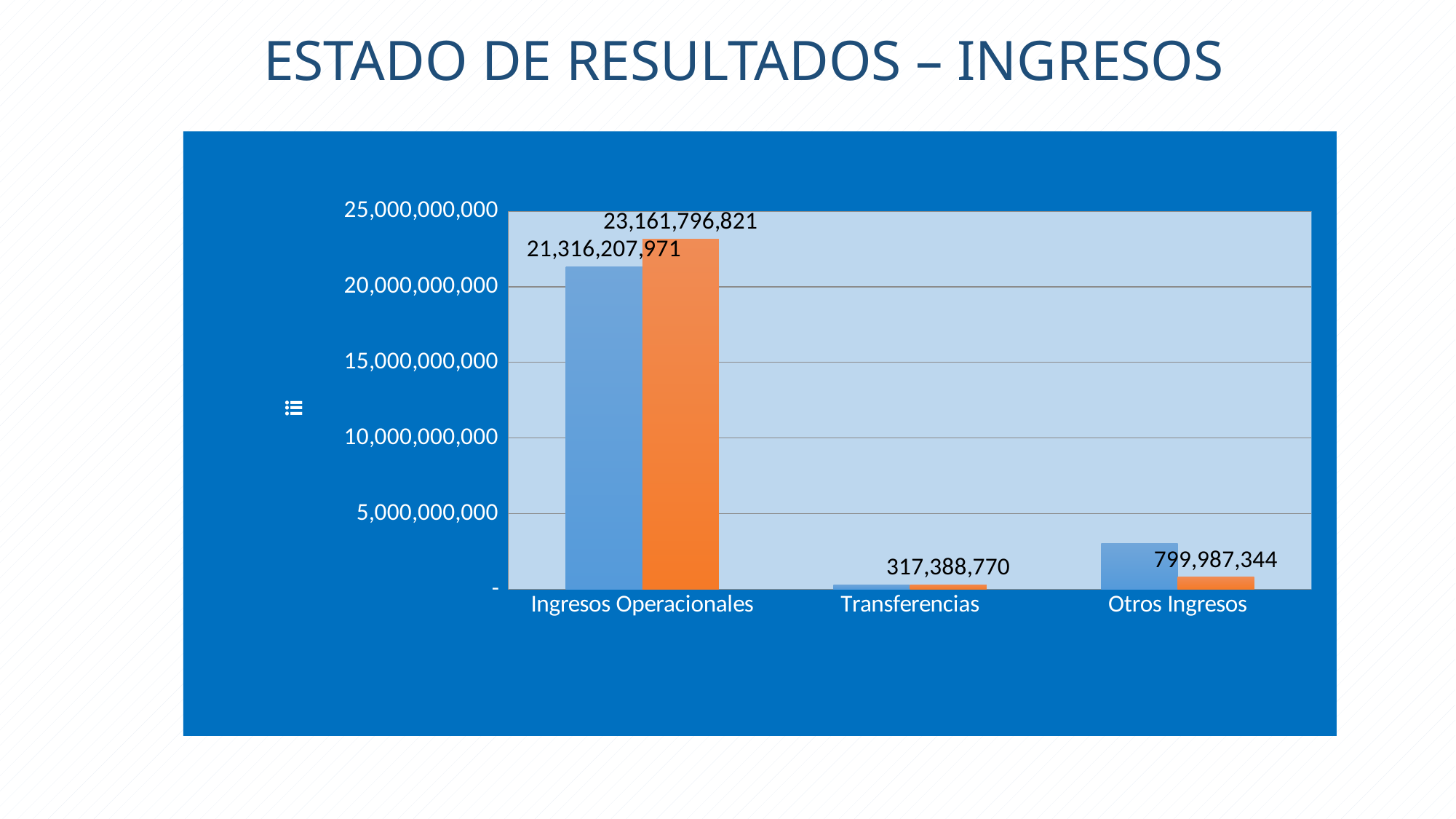
What is the title of the slide containing the chart? ESTADO DE RESULTADOS – INGRESOS What kind of chart is shown on the slide? bar chart Which category has the highest values in the chart? Ingresos Operacionales What is the difference between the orange bar and the blue bar for Ingresos Operacionales? 1,845,588,850 What value is labelled for Otros Ingresos? 799,987,344 For Ingresos Operacionales, which bar is larger, the blue one or the orange one? orange What value is labelled for Transferencias? 317,388,770 Is the value of the blue bar for Otros Ingresos greater or less than 5,000,000,000? less How many categories are shown on the x axis of the chart? 3 What is the value of the orange bar for Ingresos Operacionales? 23,161,796,821 What is the value of the blue bar for Ingresos Operacionales? 21,316,207,971 Which category has the lowest values in the chart? Transferencias